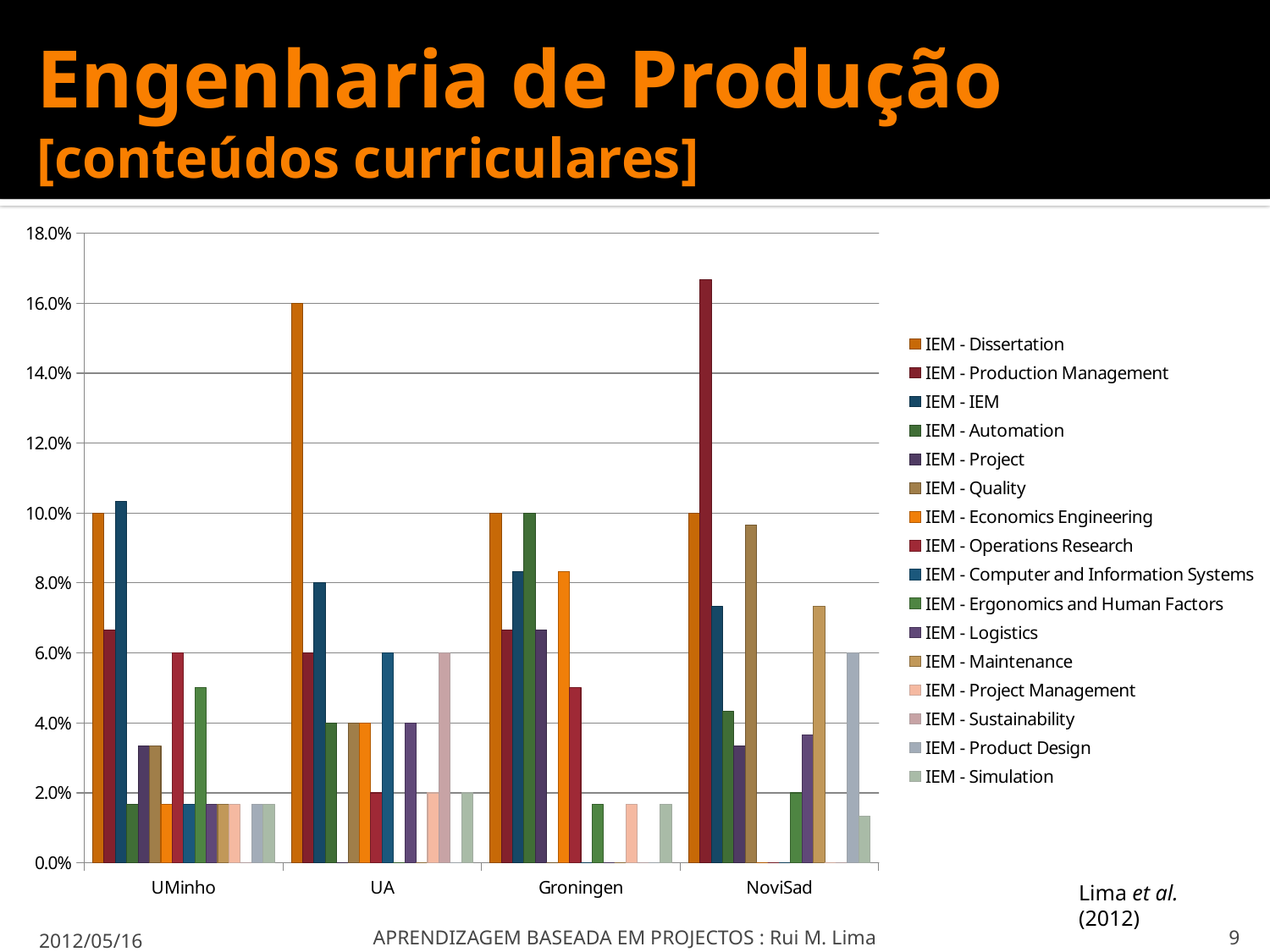
Is the value of IEM - Production Management for NoviSad greater or less than 14.0%? greater What is the value of IEM - Dissertation for UMinho? 10.0% What is the value of IEM - Dissertation for UA? 16.0% What kind of chart is shown on the slide? bar chart Which is larger: IEM - Production Management for NoviSad or IEM - Production Management for UMinho? NoviSad What is the value of IEM - Automation for Groningen? 10.0% How many institutions (categories) are shown on the x axis of the chart? 4 How many series does the chart's legend list? 16 What is the value of IEM - Product Design for NoviSad? 6.0% Which series has the highest value for UA? IEM - Dissertation What is the difference between IEM - Dissertation for UA and IEM - Dissertation for UMinho? 6.0% Which institution has the tallest bar in the chart? NoviSad